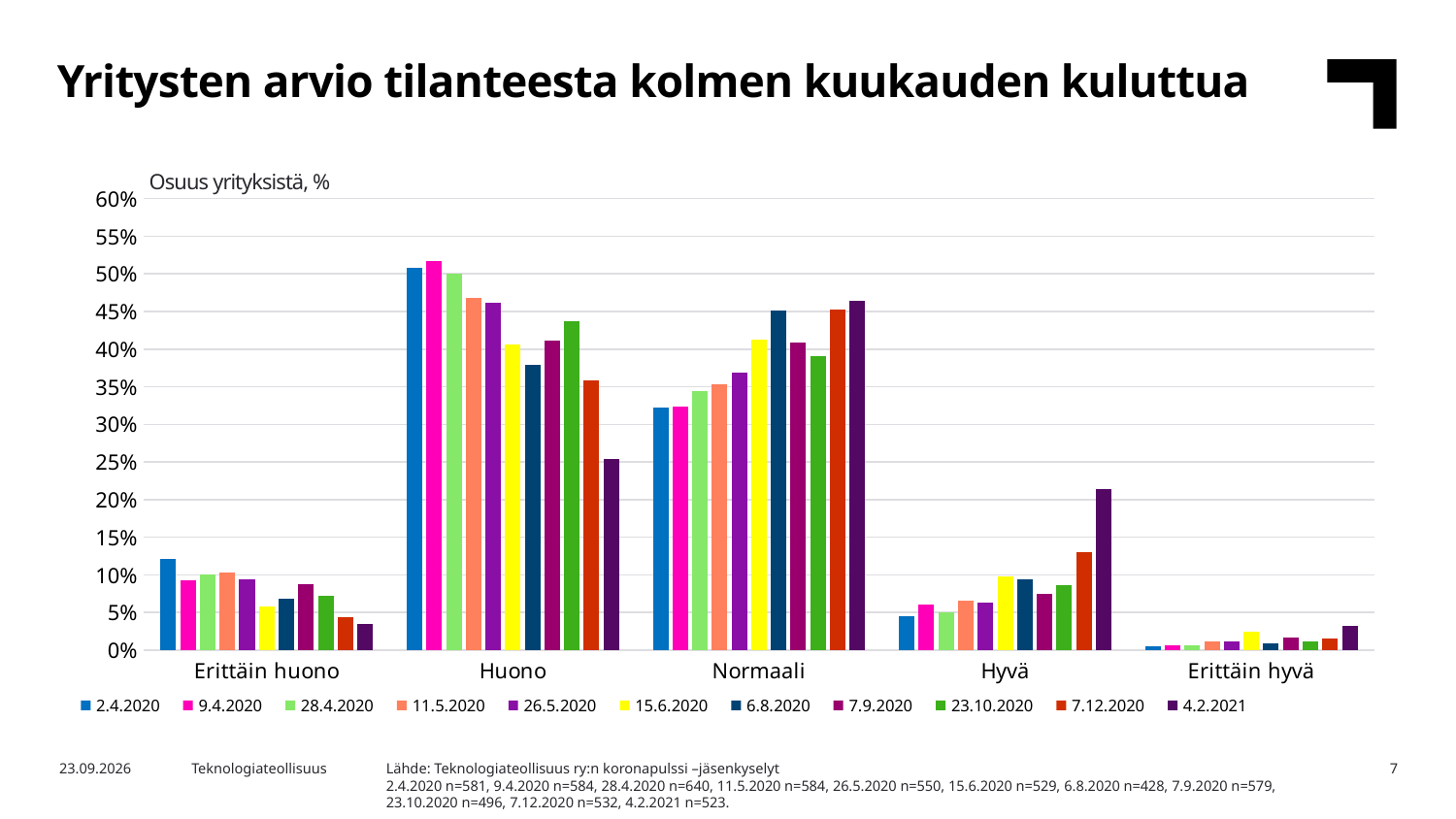
Is the value for Erittäin huono on 2.4.2020 greater or less than 10%? greater What is the label shown above the y axis of the chart? Osuus yrityksistä, % For Erittäin huono, which is larger: the value for 2.4.2020 or for 4.2.2021? 2.4.2020 Is the value for Hyvä on 4.2.2021 greater or less than 15%? greater How many categories are shown on the x axis of the chart? 5 Within the Huono category, which survey date has the lowest value? 4.2.2021 Within the Hyvä category, which survey date has the highest value? 4.2.2021 What kind of chart is shown on the slide? bar chart Is the value for Huono on 4.2.2021 greater or less than 30%? less How many series does the legend list? 11 For the 4.2.2021 series, which category has the highest value? Normaali